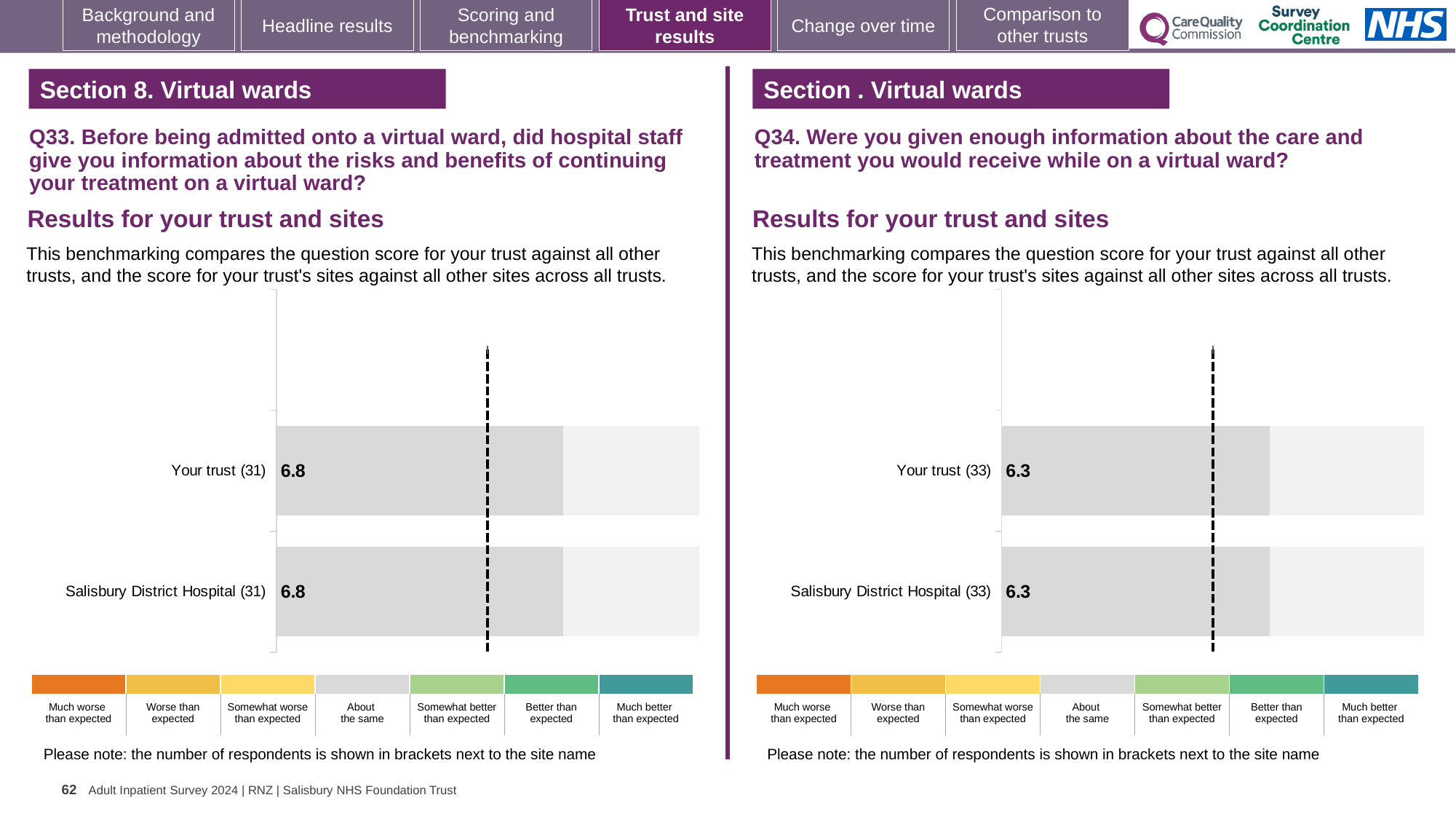
Which is larger: the Your trust score in the Q33 chart on the left or the Your trust score in the Q34 chart on the right? Q33 chart (6.8) In the Q34 chart on the right, how many respondents are shown in brackets for Salisbury District Hospital? 33 How many bars are plotted in the Q34 chart on the right? 2 What is the difference between the Your trust score in the Q33 chart on the left and the Your trust score in the Q34 chart on the right? 0.5 How many rating categories does the colour key below the Q34 chart on the right list? 7 In the Q34 chart on the right, what is the score for Your trust? 6.3 What kind of chart is used for the Q33 results on the left? Bar chart In the Q33 chart on the left, what is the score for Your trust? 6.8 How many bars are plotted in the Q33 chart on the left? 2 In the Q34 chart on the right, what is the score for Salisbury District Hospital? 6.3 In the Q33 chart on the left, what is the score for Salisbury District Hospital? 6.8 In the Q33 chart on the left, how many respondents are shown in brackets for Your trust? 31